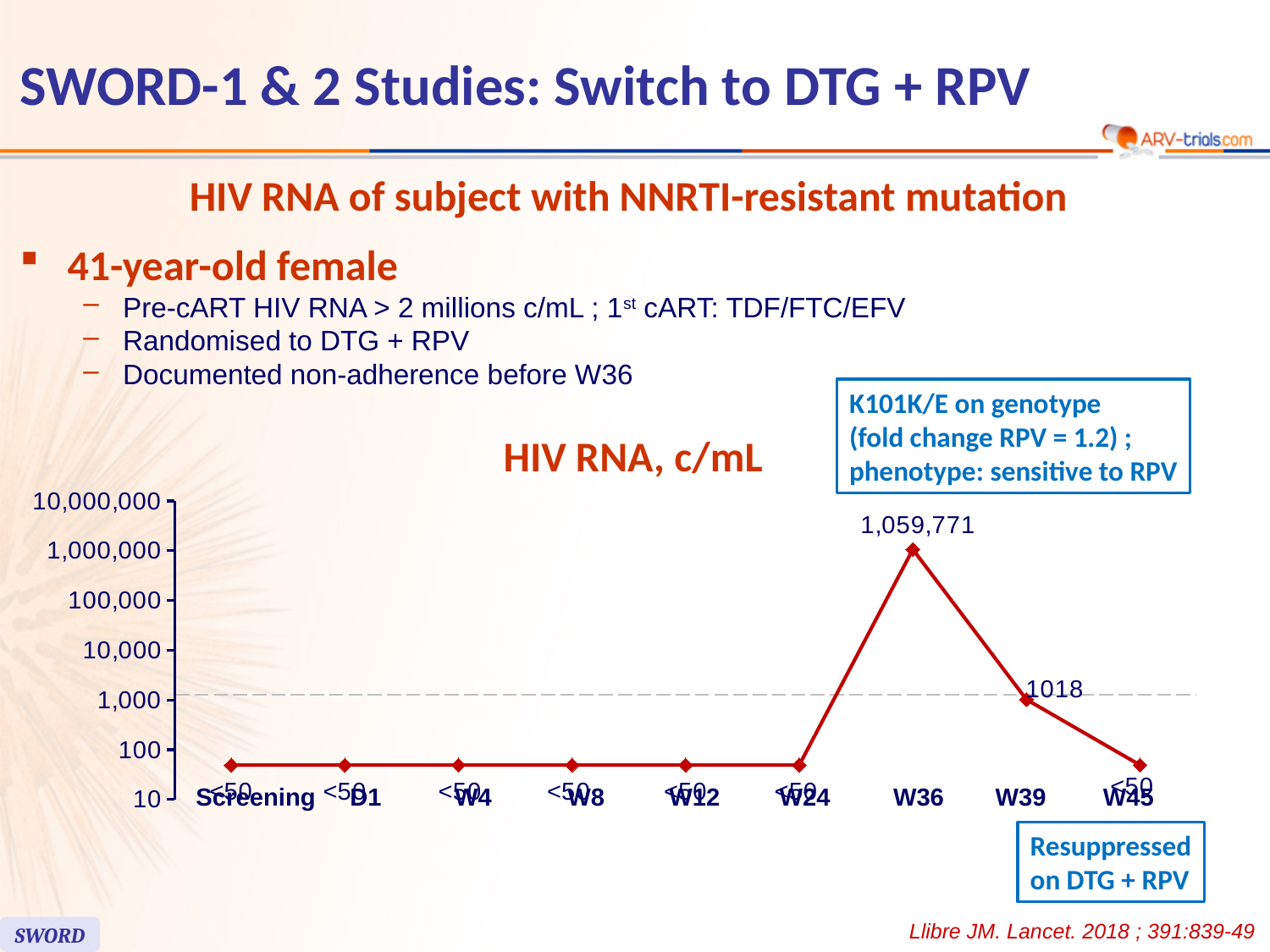
Do the HIV RNA values rise or fall from W36 to W45? Fall Is the HIV RNA value at W39 greater or less than 1,000? greater Is the HIV RNA value at W36 greater or less than 1,000,000? greater Which is larger, the HIV RNA value at W36 or at W39? W36 What is the difference between the HIV RNA values at W36 and W39? 1,058,753 What is the HIV RNA value shown at W45? <50 What is the HIV RNA value at W39? 1018 How many time points are plotted on the chart? 9 What is the HIV RNA value at W36? 1,059,771 At which time point is HIV RNA highest? W36 What kind of chart is used to show HIV RNA? Line chart What is the title of the chart? HIV RNA, c/mL